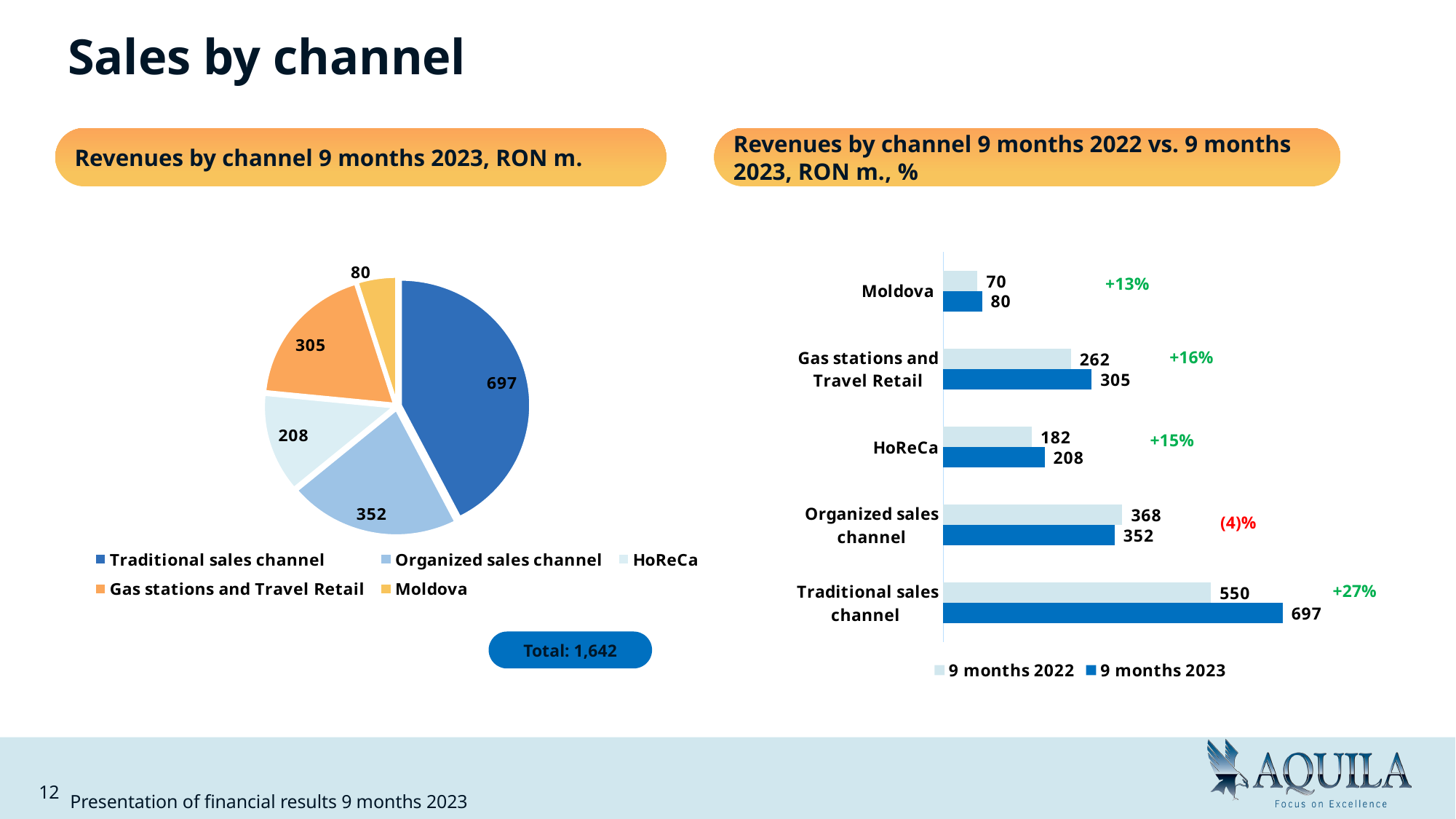
In the pie chart 'Revenues by channel 9 months 2023, RON m.', which channel has the smallest slice? Moldova In the pie chart 'Revenues by channel 9 months 2023, RON m.', what is the value for HoReCa? 208 In the bar chart 'Revenues by channel 9 months 2022 vs. 9 months 2023', what is the value for Organized sales channel in 9 months 2023? 352 What type of chart is the left chart, 'Revenues by channel 9 months 2023, RON m.'? Pie chart In the bar chart 'Revenues by channel 9 months 2022 vs. 9 months 2023', which is larger for Organized sales channel: 9 months 2022 or 9 months 2023? 9 months 2022 In the pie chart 'Revenues by channel 9 months 2023, RON m.', which channel has the largest slice? Traditional sales channel In the bar chart 'Revenues by channel 9 months 2022 vs. 9 months 2023', what is the value for Gas stations and Travel Retail in 9 months 2022? 262 In the bar chart 'Revenues by channel 9 months 2022 vs. 9 months 2023', what is the difference between the Traditional sales channel values for 9 months 2023 and 9 months 2022? 147 What type of chart is the right chart, 'Revenues by channel 9 months 2022 vs. 9 months 2023'? Bar chart In the bar chart 'Revenues by channel 9 months 2022 vs. 9 months 2023', what percentage change is shown for HoReCa? +15% How many series does the legend of the bar chart 'Revenues by channel 9 months 2022 vs. 9 months 2023' list? 2 In the pie chart 'Revenues by channel 9 months 2023, RON m.', how many slices are there? 5